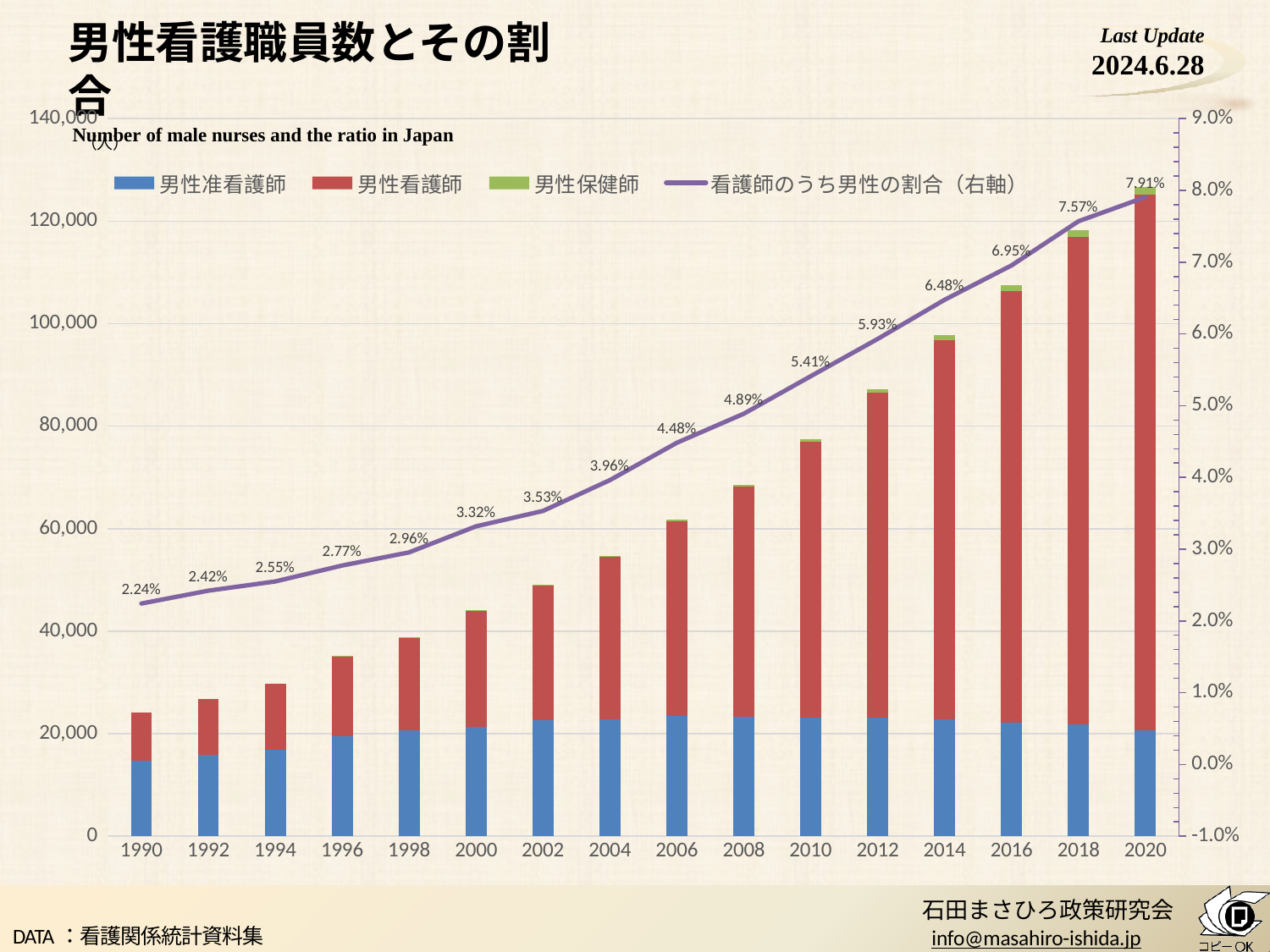
Is the total height of the stacked bar for 1990 greater or less than 40,000? less How many years are shown on the x axis? 16 What is the ratio of male nurses (right axis) shown for 2020? 7.91% What is the ratio of male nurses (right axis) shown for 2010? 5.41% Is the total height of the stacked bar for 2020 greater or less than 120,000? greater How many series does the legend list? 4 What is the ratio of male nurses (right axis) shown for 1990? 2.24% Which year has a higher ratio of male nurses, 2004 or 2006? 2006 In which year is the ratio of male nurses (right axis) highest? 2020 By how many percentage points did the ratio of male nurses rise from 2018 to 2020? 0.34 percentage points In which year is the ratio of male nurses (right axis) lowest? 1990 Does the ratio of male nurses (right axis) rise or fall from 1990 to 2020? rise